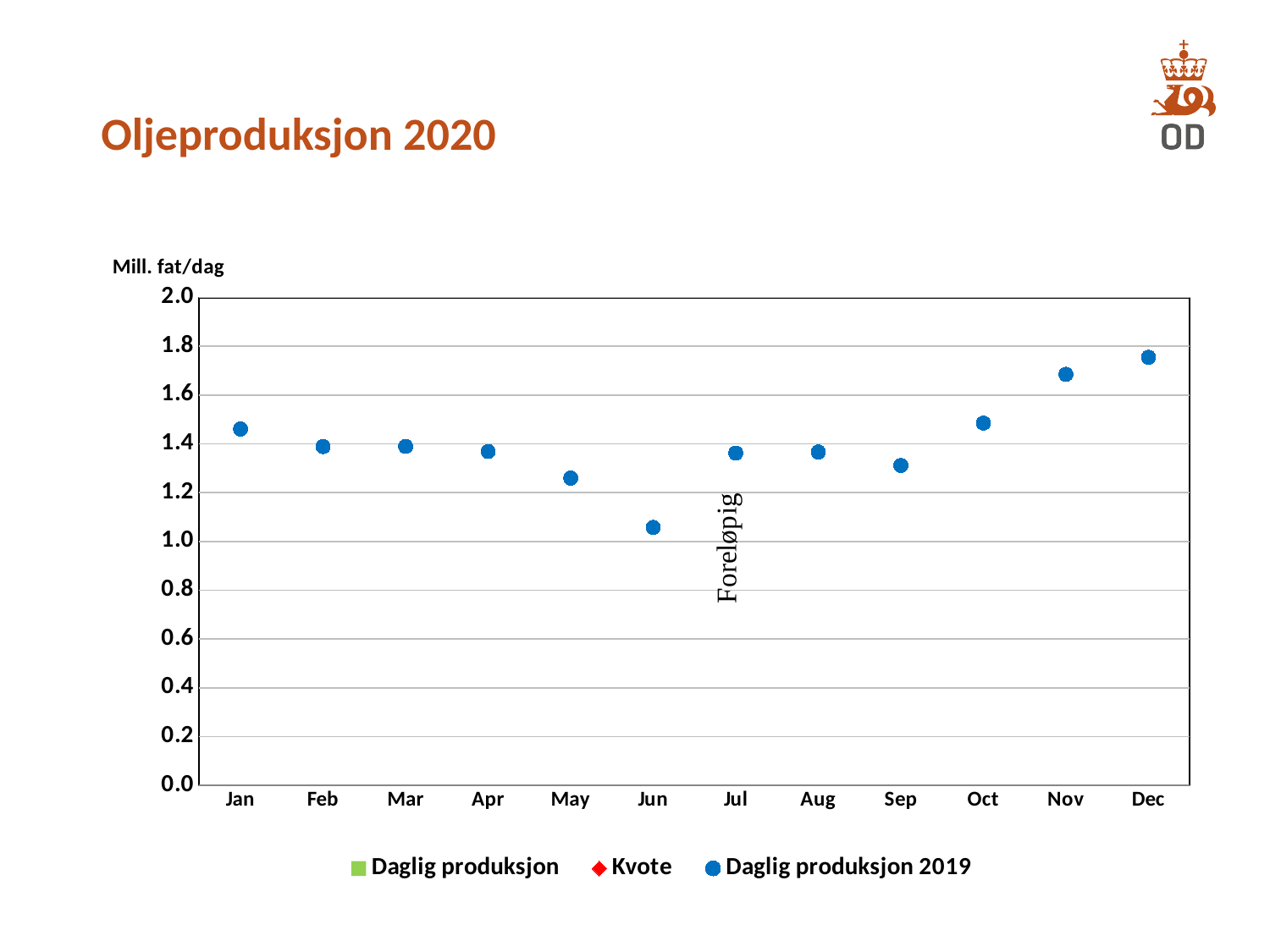
Is the Daglig produksjon 2019 value for Dec greater or less than 1.6? greater Which month has a larger Daglig produksjon 2019 value, Nov or May? Nov Is the Daglig produksjon 2019 value for Jun greater or less than 1.2? less How many series does the legend of the chart list? 3 Do the Daglig produksjon 2019 values rise or fall from Sep to Dec? rise How many months are shown along the x axis of the chart? 12 What is the title of the chart on the slide? Oljeproduksjon 2020 What unit label is shown above the y axis of the chart? Mill. fat/dag Is the Daglig produksjon 2019 value for Jan greater or less than 1.4? greater Which month has a larger Daglig produksjon 2019 value, Jun or Sep? Sep In which month is the Daglig produksjon 2019 value lowest? Jun In which month is the Daglig produksjon 2019 value highest? Dec